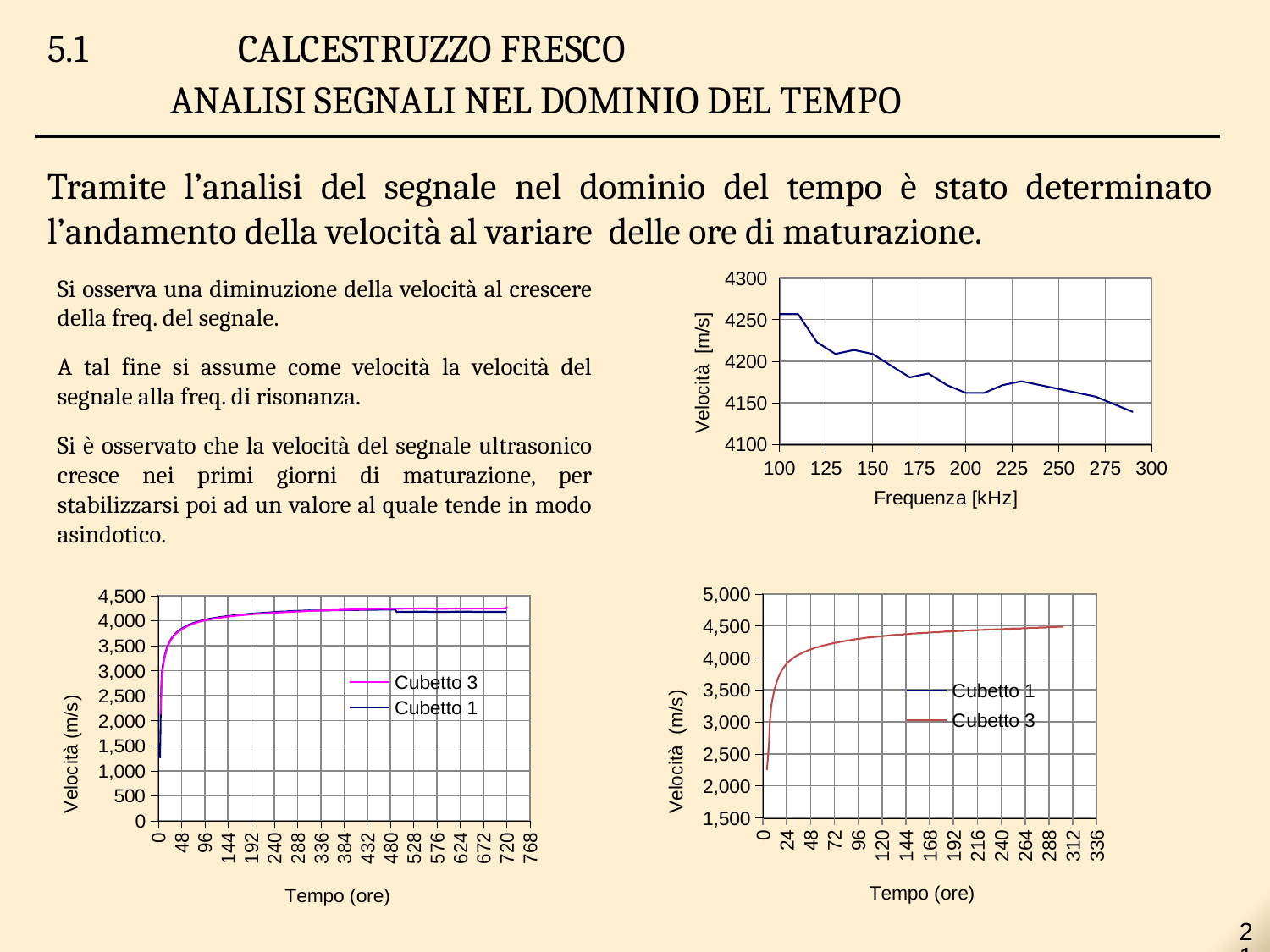
In the bottom-right chart, is the velocity at 288 hours greater or less than 4,000 m/s? greater In the bottom-left chart, does the velocity rise or fall as time increases? rise How many series does the legend of the bottom-left chart list? 2 What kind of chart is the top-right chart with Frequenza [kHz] on the x axis? line chart What is the x-axis label of the top-right chart? Frequenza [kHz] In the top-right chart, is the velocity at 200 kHz greater or less than 4200 m/s? less In the top-right chart, is the velocity at 250 kHz greater or less than 4200 m/s? less What kind of chart is the bottom-left chart? line chart Which series names appear in the legend of the bottom-right chart? Cubetto 1 and Cubetto 3 How many series does the legend of the bottom-right chart list? 2 In the top-right chart, does the velocity rise or fall as the frequency increases from 100 to 300 kHz? fall